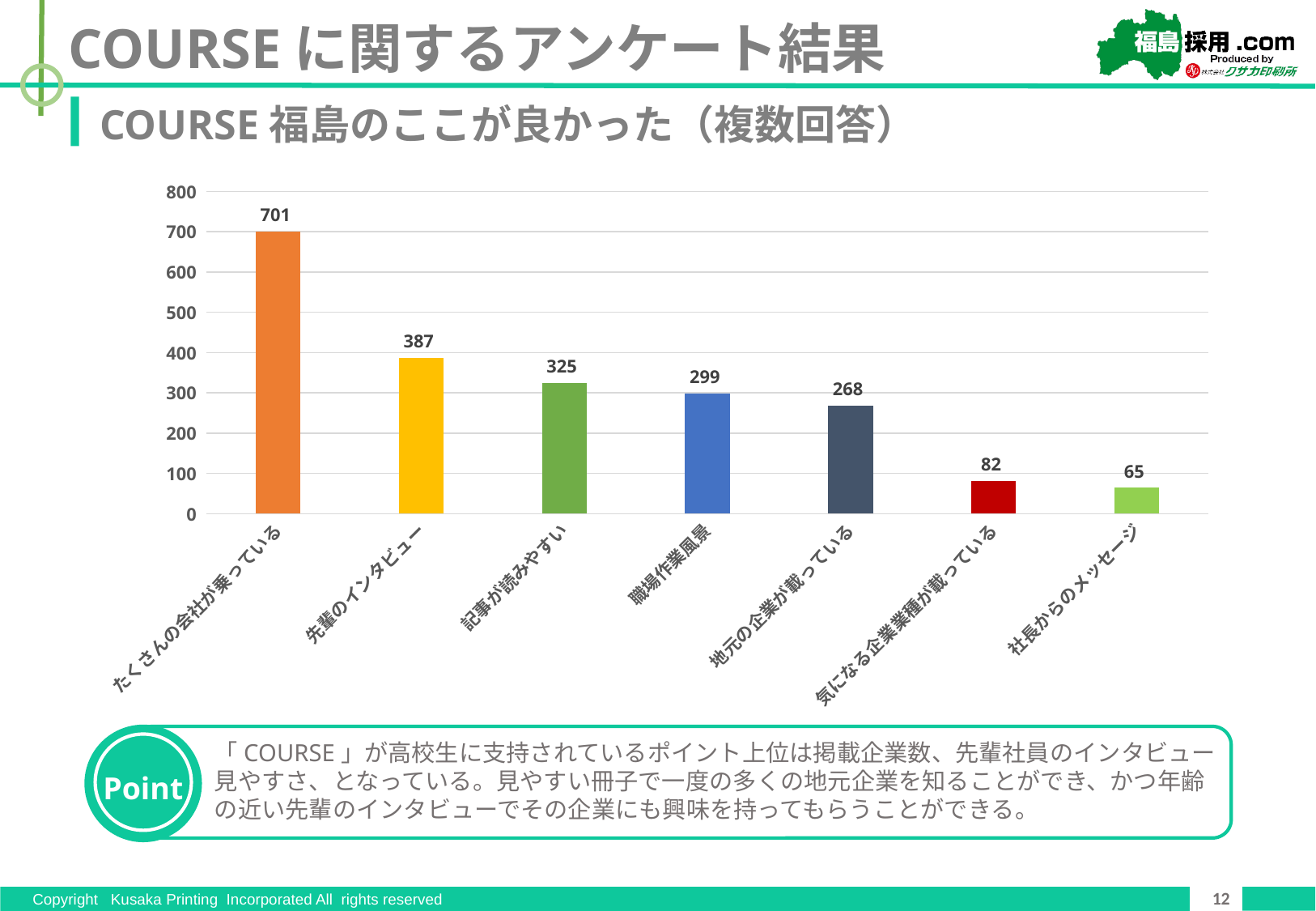
What is the value for たくさんの会社が乗っている? 701 What is the value for 職場作業風景? 299 What is the value for 社長からのメッセージ? 65 Which is larger, the value for 気になる企業業種が載っている or the value for 社長からのメッセージ? 気になる企業業種が載っている Which category has the highest value? たくさんの会社が乗っている Is the value for 地元の企業が載っている greater or less than 300? less What is the difference between the values for たくさんの会社が乗っている and 先輩のインタビュー? 314 What is the value for 先輩のインタビュー? 387 Which category has the lowest value? 社長からのメッセージ What is the difference between the values for 記事が読みやすい and 地元の企業が載っている? 57 How many categories are shown in the chart? 7 What kind of chart is shown on the slide? bar chart